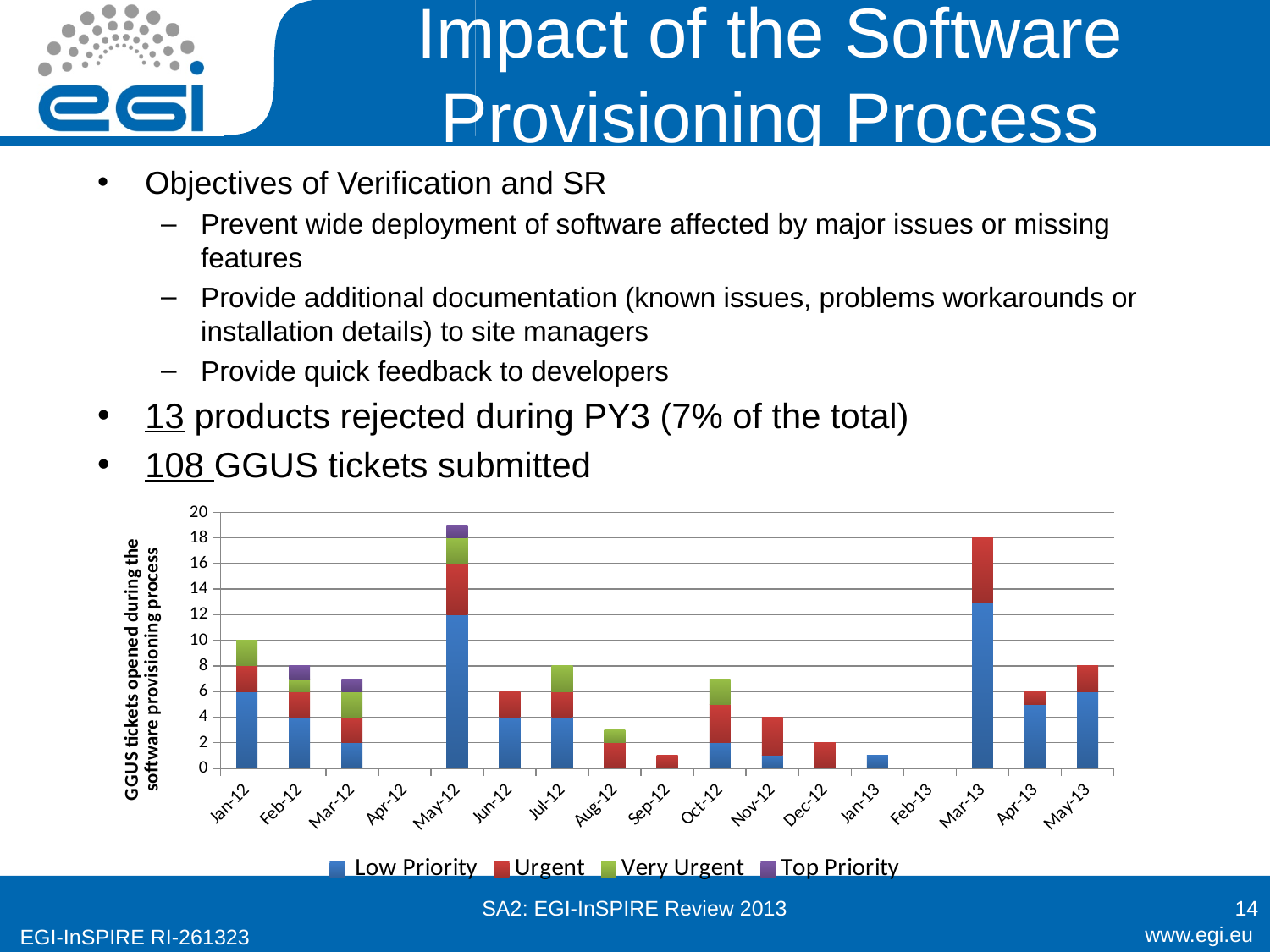
What is the difference between the total tickets in Mar-13 and the total tickets in Apr-13? 12 How many Low Priority tickets were opened in May-12? 12 Is the total number of tickets in Mar-13 greater or less than 16? greater What is the total number of GGUS tickets opened in Mar-13? 18 Is the total number of tickets in Aug-12 greater or less than 4? less What is the total number of GGUS tickets opened in Jan-12? 10 How many months are shown on the x axis of the chart? 17 Which months show no tickets opened at all? Apr-12 and Feb-13 How many Low Priority tickets were opened in Jan-12? 6 Which month has the larger total of tickets, Jan-12 or Feb-12? Jan-12 What kind of chart is shown on the slide? Stacked bar chart How many series does the chart legend list? 4